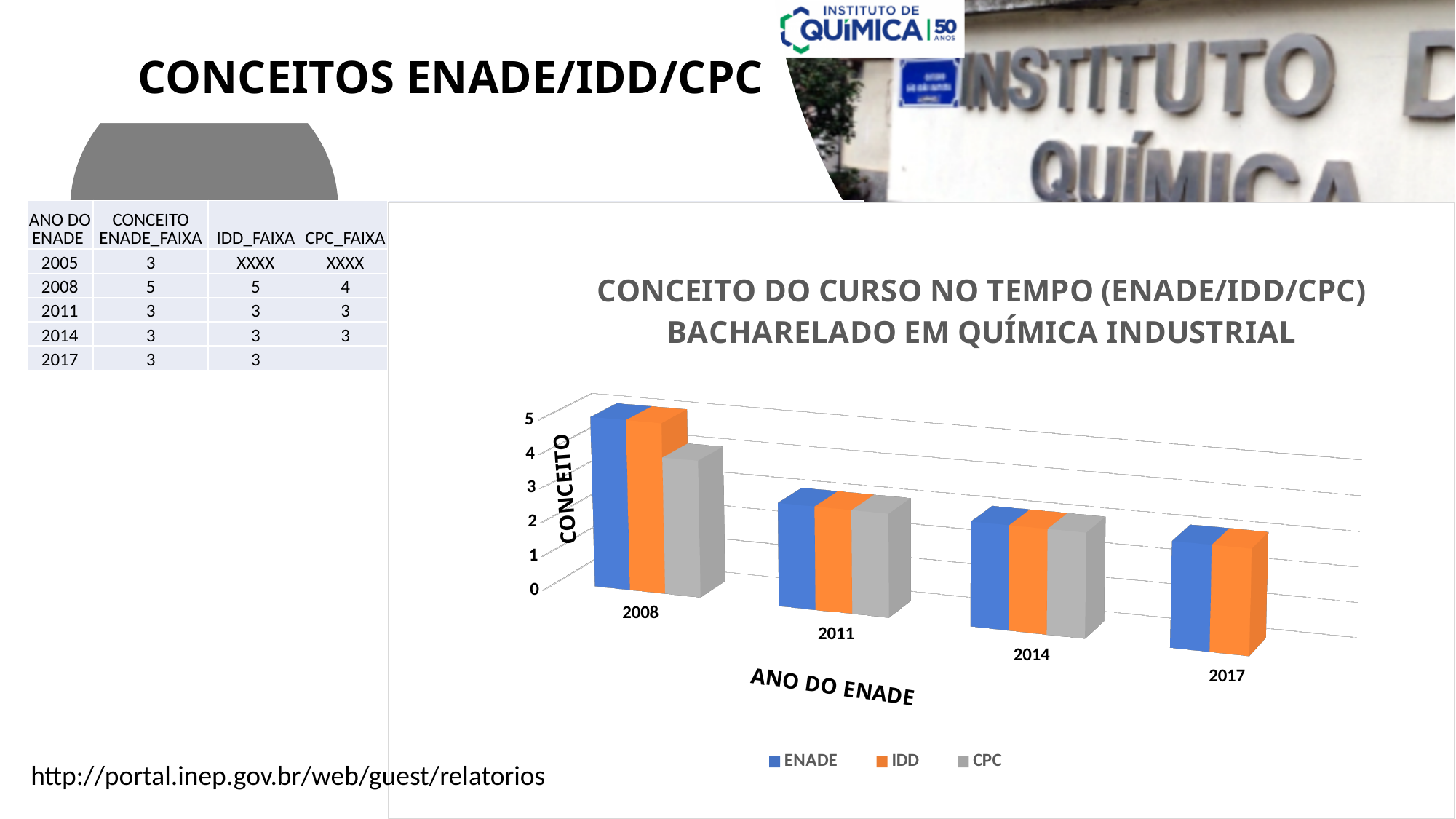
Is the ENADE value for 2011 greater or less than 4? less How many series does the chart legend list? 3 What is the ENADE value for 2008? 5 Which is larger for 2008, the IDD value or the CPC value? IDD What is the CPC value for 2008? 4 What kind of chart is shown on the slide? bar chart Is the IDD value for 2008 greater or less than 4? greater How many years are shown on the x axis of the chart? 4 What is the IDD value for 2014? 3 Which year in the chart has no CPC bar? 2017 Which year has the highest ENADE value in the chart? 2008 What is the label of the vertical axis of the chart? CONCEITO